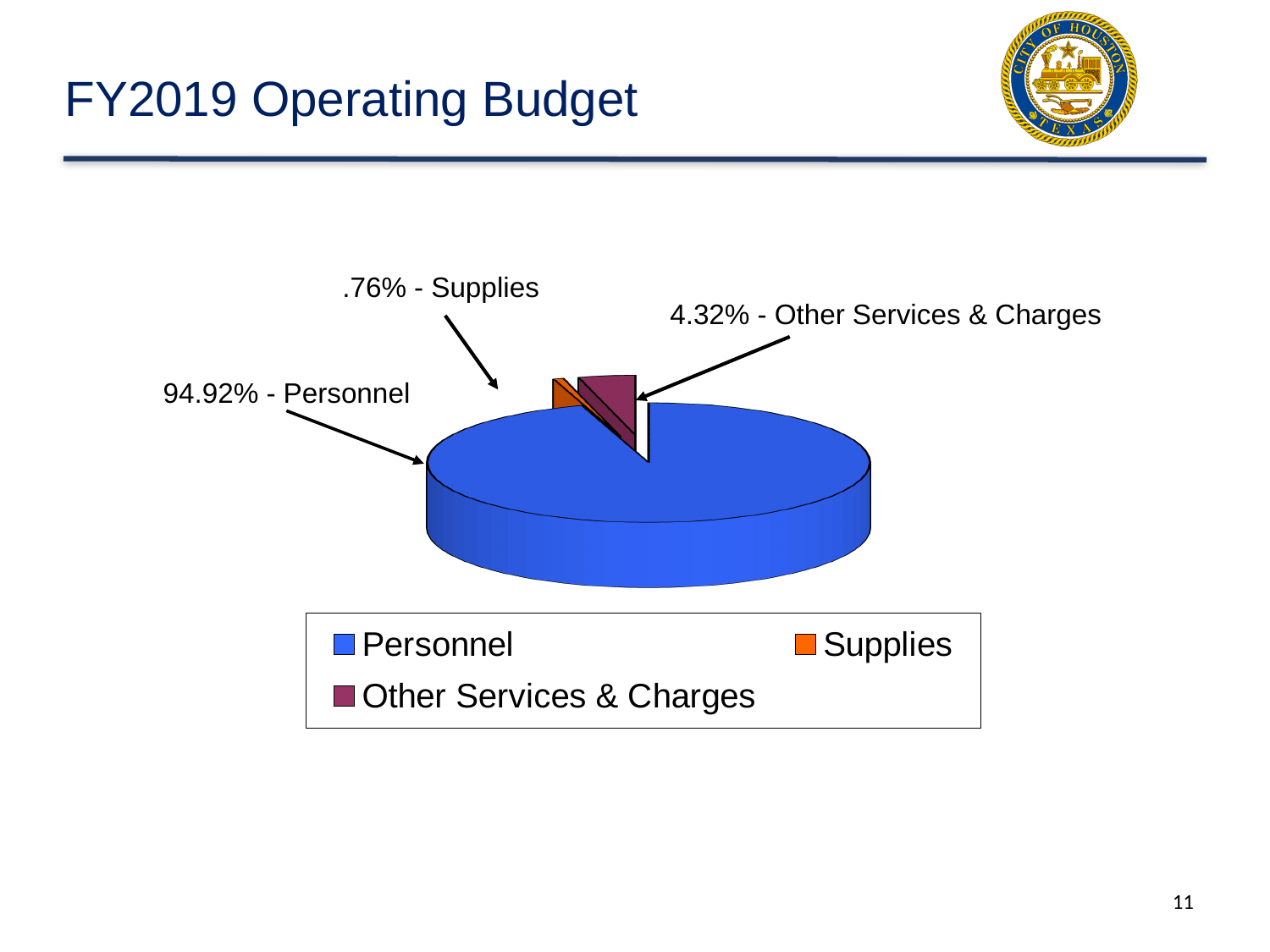
How many categories are shown in the pie chart? 3 Which category has the largest slice of the pie chart? Personnel What is the title of the slide containing the chart? FY2019 Operating Budget What is the difference between the Personnel share and the Other Services & Charges share? 90.60% What share of the pie chart is Other Services & Charges? 4.32% What colour represents Supplies in the legend? Orange What share of the pie chart is Supplies? .76% What is the difference between the Other Services & Charges share and the Supplies share? 3.56% Which category has the smallest slice of the pie chart? Supplies Which is larger, the share for Supplies or the share for Other Services & Charges? Other Services & Charges What kind of chart is shown on the slide? Pie chart What share of the FY2019 Operating Budget pie chart is Personnel? 94.92%